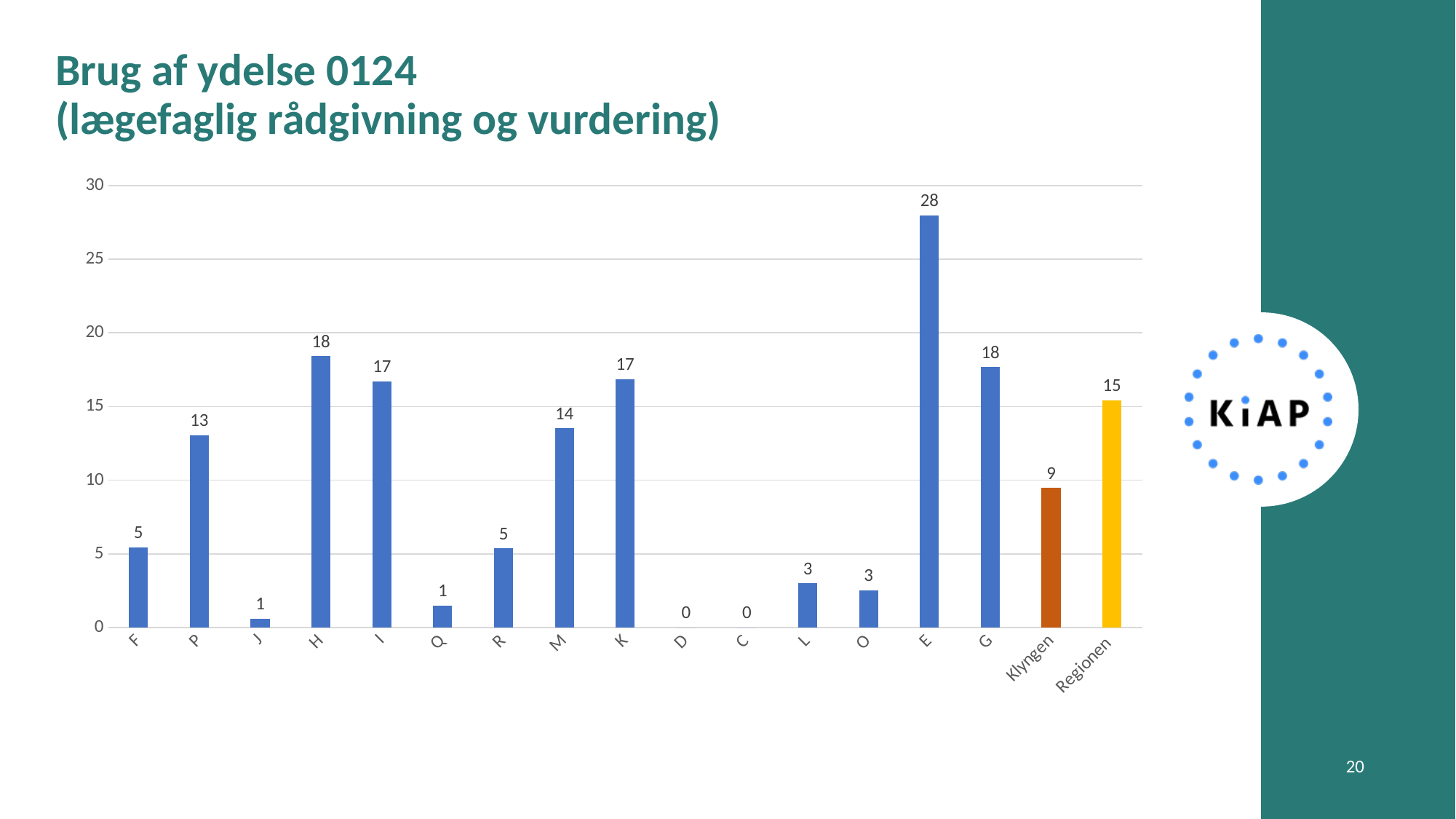
Is the value for H greater or less than 15? greater What is the difference between the values for E and G? 10 What is the value for E? 28 What is the value for Klyngen? 9 What is the value for P? 13 How many categories are shown on the x axis? 17 What is the difference between the values for Regionen and Klyngen? 6 What colour is the bar for Regionen? Yellow What is the value for Regionen? 15 Which category has the highest value? E Which has a larger value, M or P? M What kind of chart is shown on the slide? Bar chart